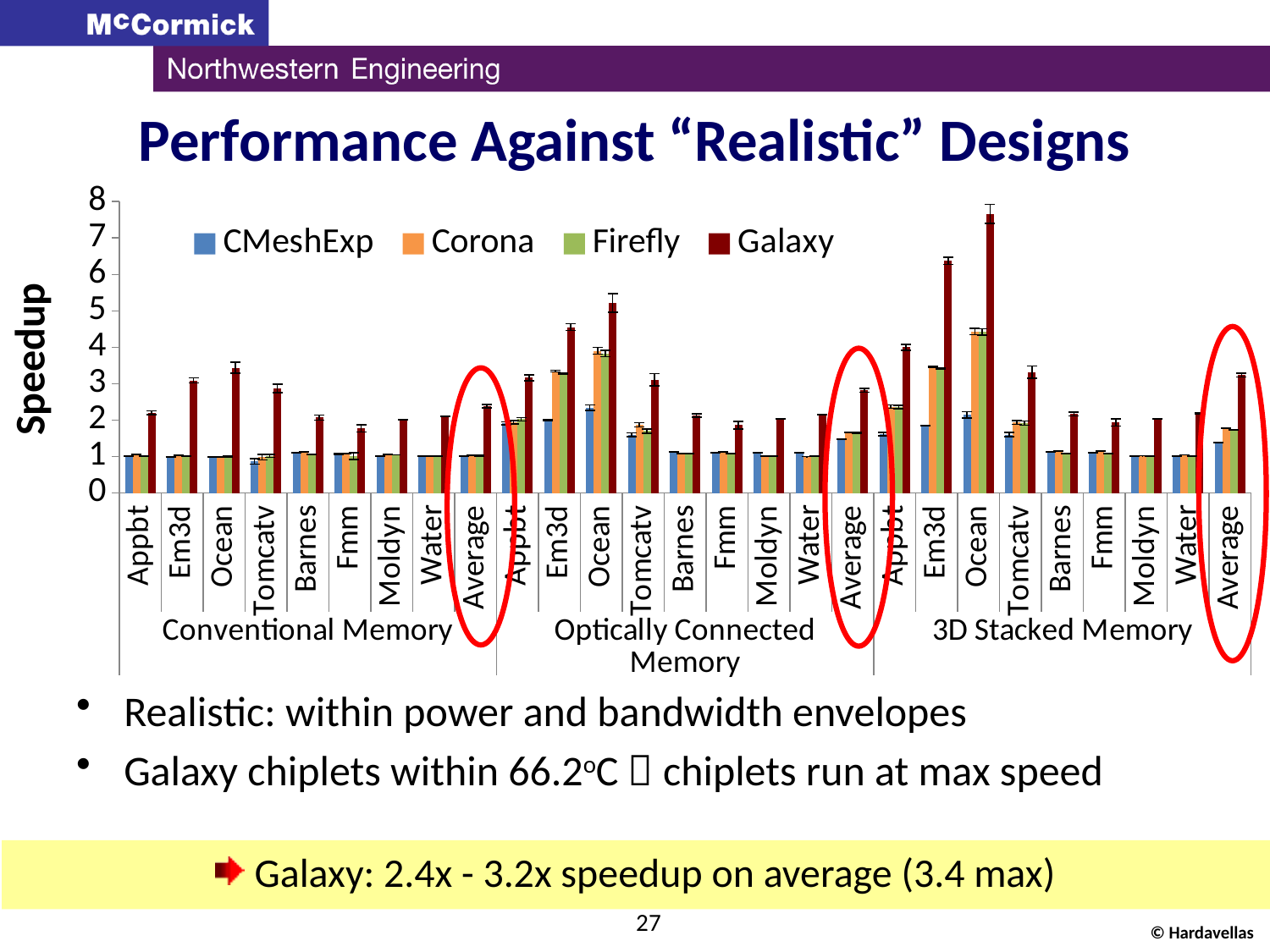
Is the Galaxy value for Average in the Conventional Memory group greater or less than 3? less Which series has the highest bar for Ocean in the 3D Stacked Memory group? Galaxy Is the Galaxy value for Ocean in the 3D Stacked Memory group greater or less than 6? greater What kind of chart is shown on the slide? bar chart Is the Galaxy value for Ocean in the Optically Connected Memory group greater or less than 4? greater How many series does the chart legend list? 4 Which series is drawn in dark red in the chart? Galaxy What is the label of the chart's y axis? Speedup How many memory configuration groups are shown along the x axis of the chart? 3 How many categories (benchmarks plus Average) are plotted within the Conventional Memory group? 9 Which is larger: the Galaxy value for Ocean in the 3D Stacked Memory group or the Galaxy value for Ocean in the Optically Connected Memory group? Ocean in 3D Stacked Memory